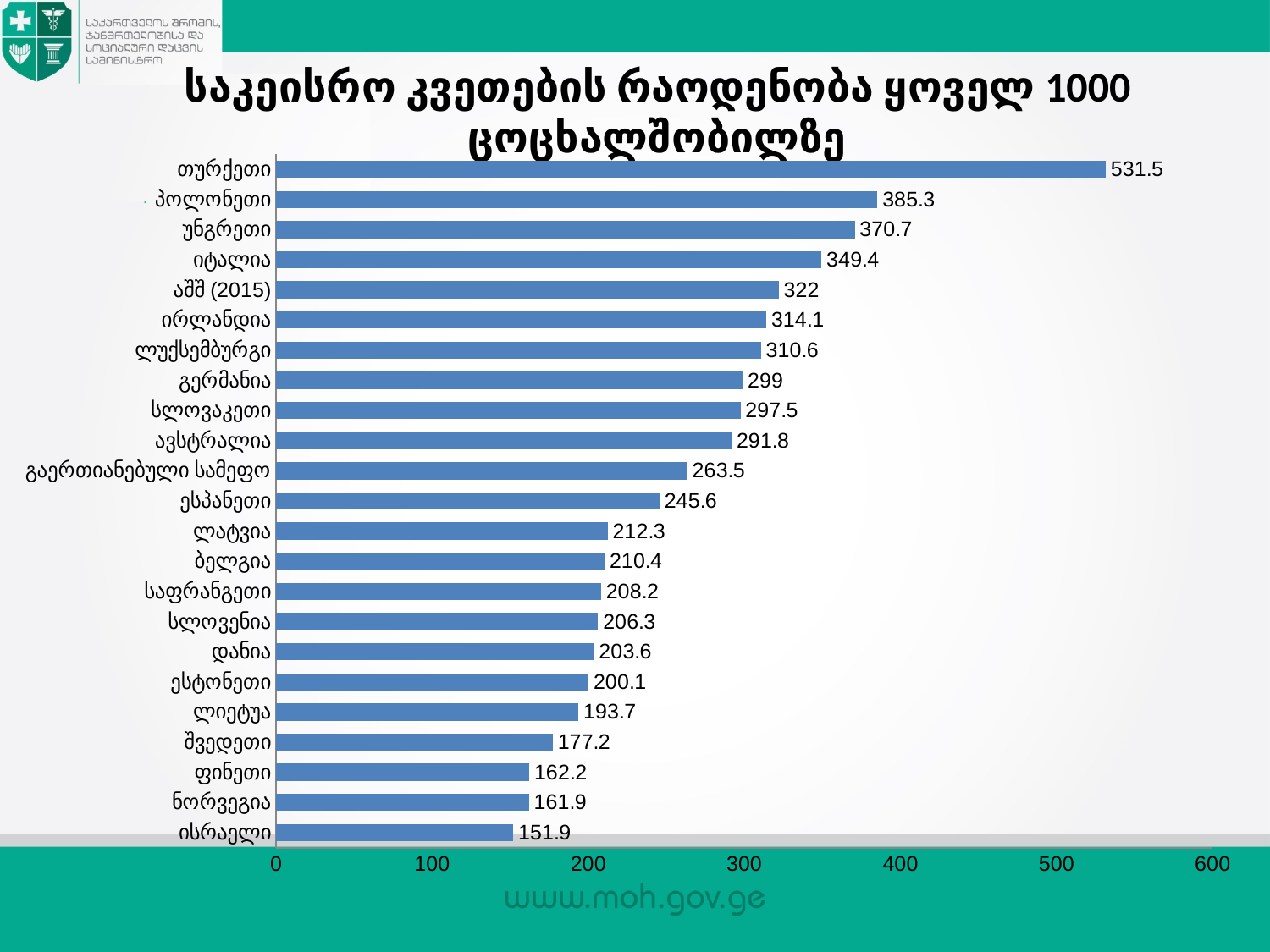
What is the difference between the values for ფინეთი and ნორვეგია? 0.3 What is the value for თურქეთი? 531.5 Which category has the lowest value? ისრაელი What is the value for აშშ (2015)? 322 What is the title of the chart? საკეისრო კვეთების რაოდენობა ყოველ 1000 ცოცხალშობილზე Is the value for ესპანეთი greater or less than 300? less Which category has the highest value? თურქეთი Which has a larger value, იტალია or უნგრეთი? უნგრეთი How many categories are shown in the chart? 23 What kind of chart is shown on the slide? bar chart What is the difference between the values for თურქეთი and პოლონეთი? 146.2 What is the value for გერმანია? 299